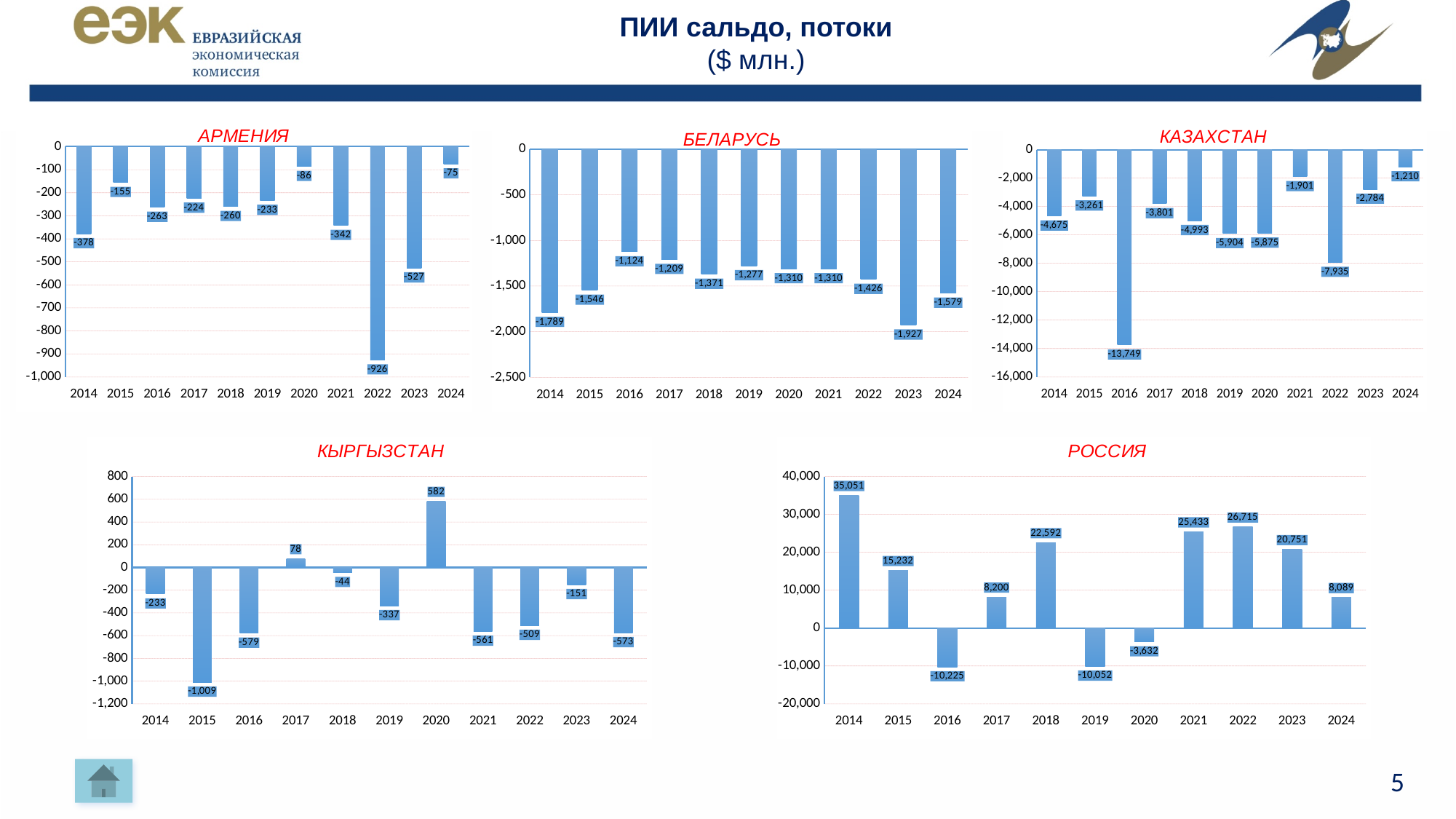
In the КЫРГЫЗСТАН chart, which year has the highest value? 2020 How many charts are shown on the slide? 5 In the РОССИЯ chart, what is the value for 2014? 35,051 In the КАЗАХСТАН chart, what is the value for 2016? -13,749 In the РОССИЯ chart, what is the difference between the values for 2022 and 2021? 1,282 In the БЕЛАРУСЬ chart, which year has the lowest value? 2023 In the БЕЛАРУСЬ chart, what is the value for 2020? -1,310 What kind of chart is the РОССИЯ chart? bar chart In the РОССИЯ chart, which is larger, the value for 2015 or the value for 2017? 2015 In the КЫРГЫЗСТАН chart, how many years are shown on the x axis? 11 In the КЫРГЫЗСТАН chart, how many years have a positive value? 2 In the АРМЕНИЯ chart, what is the value for 2022? -926